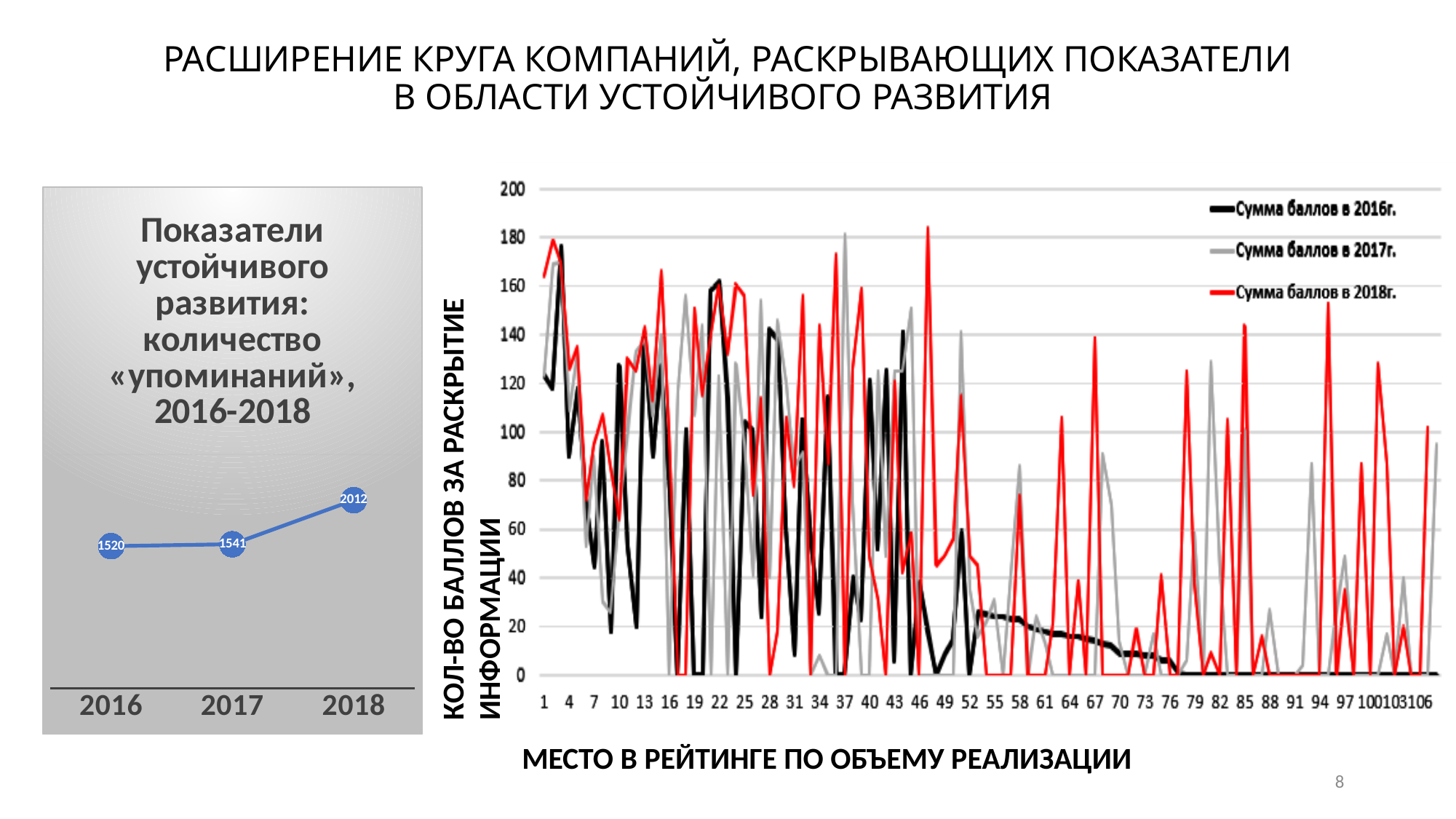
In the left chart (Показатели устойчивого развития), which year has the lowest value? 2016 In the left chart (Показатели устойчивого развития), what is the value for 2016? 1520 In the left chart (Показатели устойчивого развития), do the values rise or fall from 2016 to 2018? rise In the right chart, how many series does the legend list? 3 In the right chart, what is the title of the x axis? МЕСТО В РЕЙТИНГЕ ПО ОБЪЕМУ РЕАЛИЗАЦИИ In the left chart (Показатели устойчивого развития), which year has the highest value? 2018 In the left chart (Показатели устойчивого развития), how many data points are plotted? 3 In the left chart (Показатели устойчивого развития), what is the difference between the 2018 and 2017 values? 471 In the left chart (Показатели устойчивого развития), what is the difference between the 2017 and 2016 values? 21 In the left chart (Показатели устойчивого развития), what is the value for 2018? 2012 What kind of chart is the left chart (Показатели устойчивого развития)? line chart In the left chart (Показатели устойчивого развития), what is the value for 2017? 1541